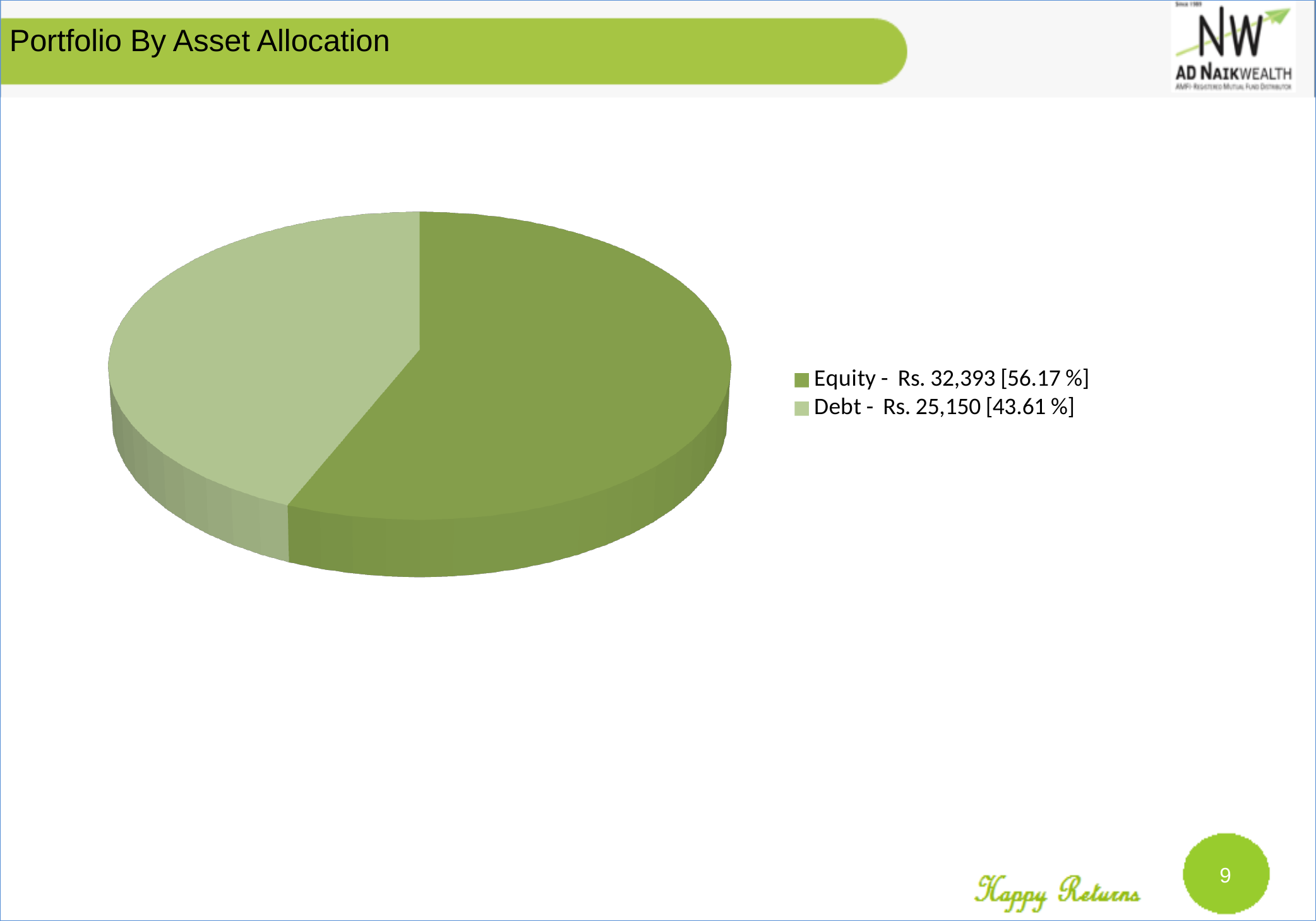
Which asset class is shown in the darker green colour in the pie chart? Equity Which asset class has the largest slice in the pie chart? Equity What is the value of the Debt slice in the pie chart? Rs. 25,150 What is the title of the slide containing the chart? Portfolio By Asset Allocation What percentage share of the pie does Equity represent? 56.17 % What percentage share of the pie does Debt represent? 43.61 % Which asset class has the smallest slice in the pie chart? Debt How many slices does the pie chart have? 2 Which is larger, the Equity value or the Debt value? Equity What is the difference in rupees between the Equity and Debt values? Rs. 7,243 What is the value of the Equity slice in the pie chart? Rs. 32,393 What kind of chart is shown on the slide? Pie chart